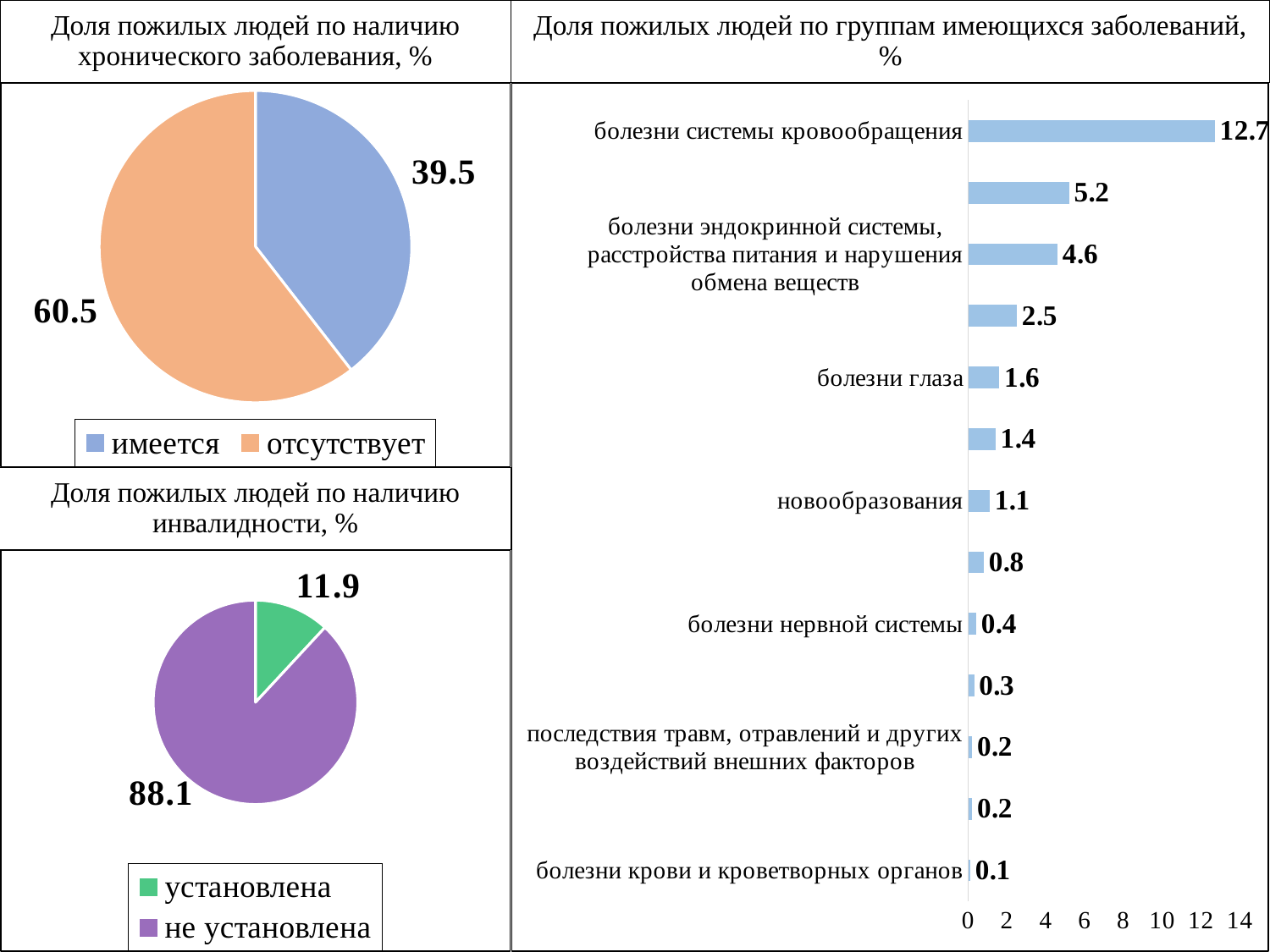
In the chart 'Доля пожилых людей по наличию хронического заболевания, %', what is the value for 'имеется'? 39.5 In the chart 'Доля пожилых людей по группам имеющихся заболеваний, %', which is larger: 'новообразования' or 'болезни нервной системы'? новообразования In the chart 'Доля пожилых людей по группам имеющихся заболеваний, %', what is the difference between 'болезни системы кровообращения' and 'болезни эндокринной системы, расстройства питания и нарушения обмена веществ'? 8.1 In the chart 'Доля пожилых людей по наличию инвалидности, %', what is the value for 'установлена'? 11.9 How many bars are plotted in the chart 'Доля пожилых людей по группам имеющихся заболеваний, %'? 13 In the chart 'Доля пожилых людей по группам имеющихся заболеваний, %', what is the value for 'болезни глаза'? 1.6 In the chart 'Доля пожилых людей по наличию хронического заболевания, %', what is the value for 'отсутствует'? 60.5 In the chart 'Доля пожилых людей по группам имеющихся заболеваний, %', which category has the lowest value? болезни крови и кроветворных органов In the chart 'Доля пожилых людей по группам имеющихся заболеваний, %', what is the value for 'болезни системы кровообращения'? 12.7 In the chart 'Доля пожилых людей по наличию инвалидности, %', what is the difference between 'не установлена' and 'установлена'? 76.2 What type of chart is 'Доля пожилых людей по наличию хронического заболевания, %'? pie chart In the chart 'Доля пожилых людей по наличию инвалидности, %', which category is the largest? не установлена